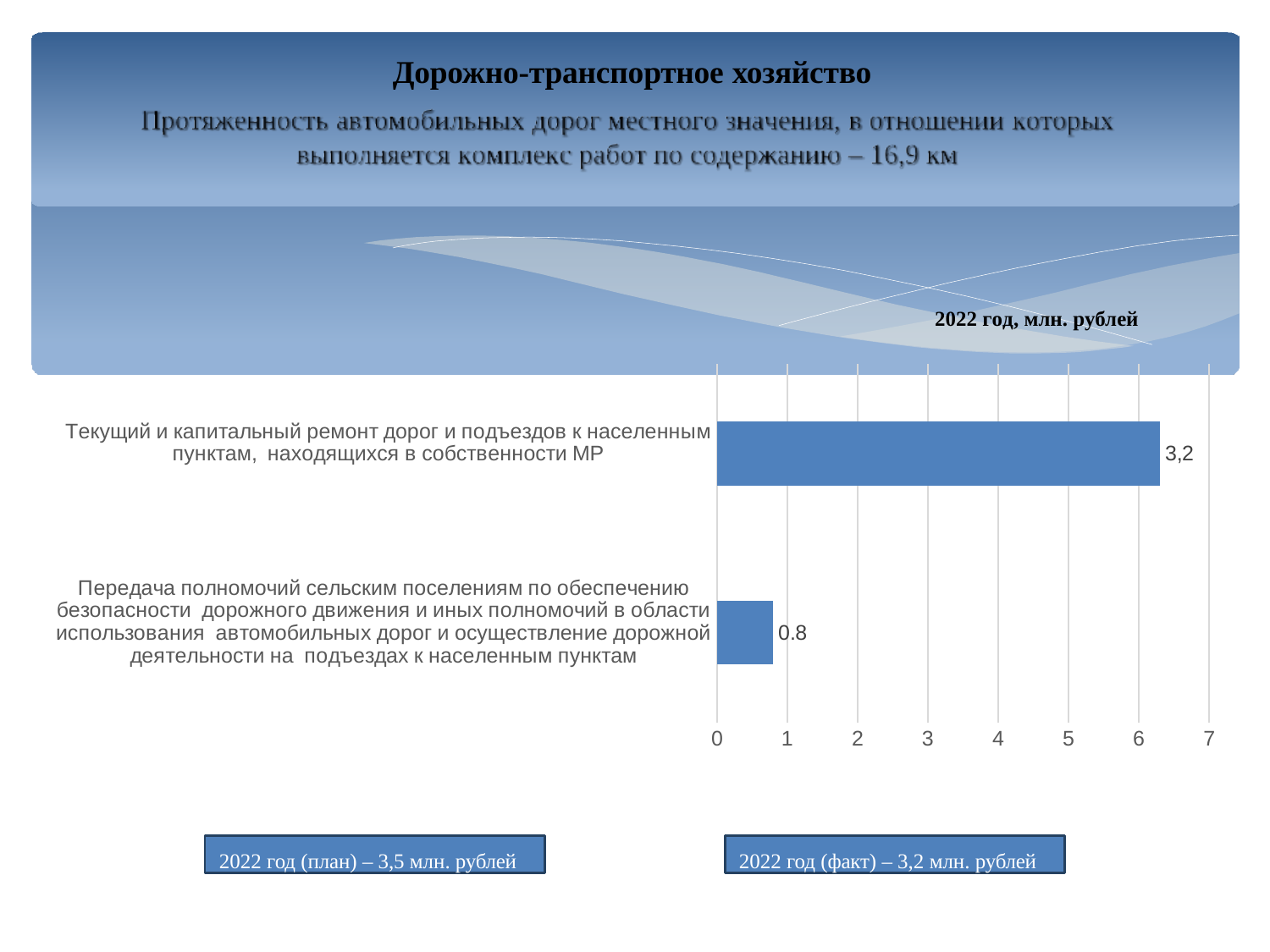
What is the value for «Текущий и капитальный ремонт дорог и подъездов к населенным пунктам, находящихся в собственности МР»? 3,2 Which is larger: the value for «Текущий и капитальный ремонт дорог...» or the value for «Передача полномочий сельским поселениям...»? Текущий и капитальный ремонт дорог... Which category has the highest value? Текущий и капитальный ремонт дорог и подъездов к населенным пунктам, находящихся в собственности МР What is the value for «Передача полномочий сельским поселениям по обеспечению безопасности дорожного движения...»? 0.8 What is the title of the chart? 2022 год, млн. рублей Is the value for «Передача полномочий сельским поселениям...» greater or less than 1? less How many categories are shown in the chart? 2 What is the highest tick value shown on the horizontal axis? 7 What kind of chart is shown on the slide? bar chart